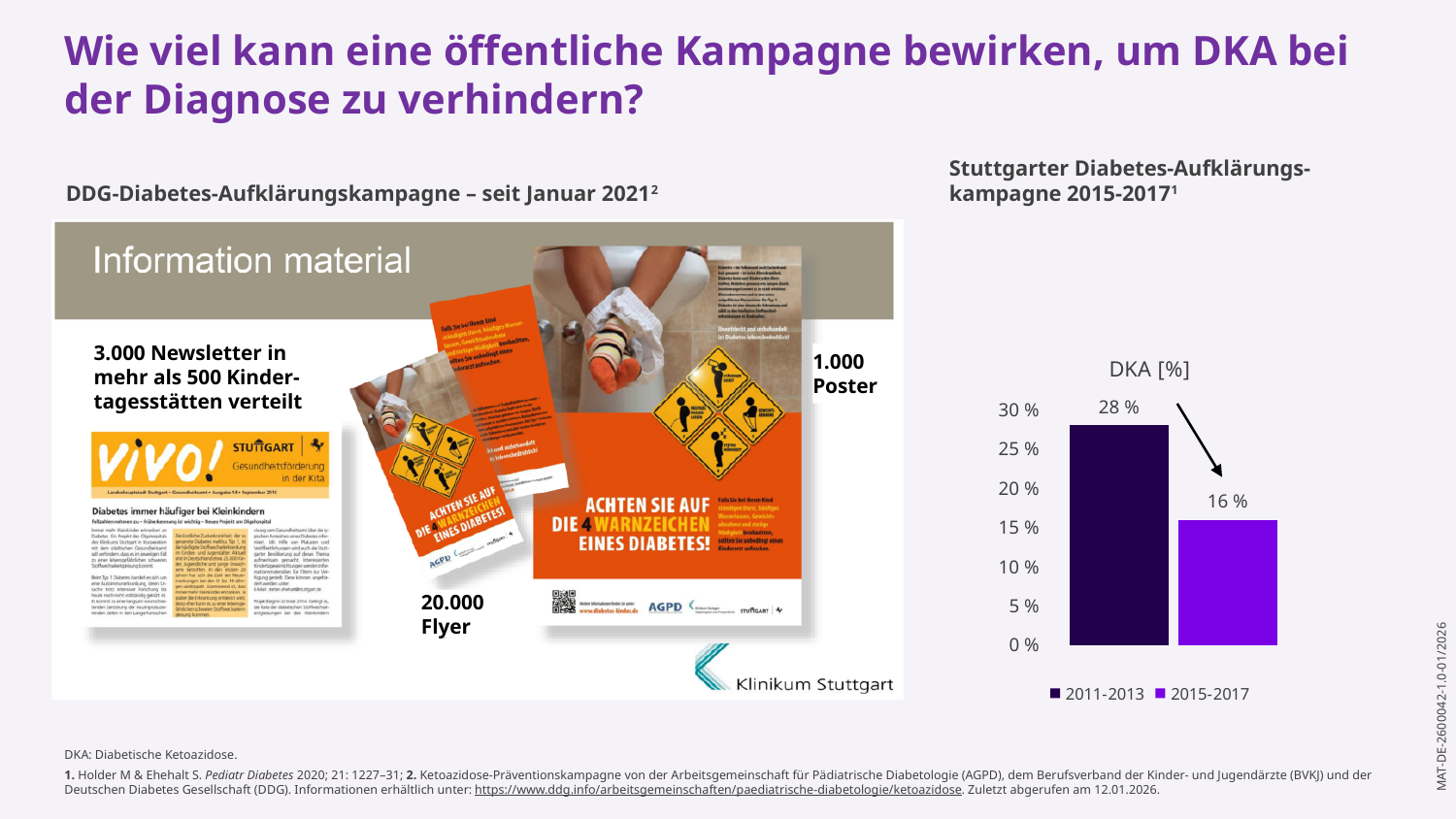
What is the title of the chart? DKA [%] Which period has the lower DKA value? 2015-2017 How many entries does the chart legend list? 2 Which period has the higher DKA value? 2011-2013 What is the DKA value for 2011-2013? 28 % Is the DKA value for 2015-2017 greater or less than 20 %? less Is the DKA value for 2011-2013 greater or less than 25 %? greater What is the difference between the DKA values for 2011-2013 and 2015-2017? 12 % What is the DKA value for 2015-2017? 16 % Is the DKA value for 2015-2017 larger or smaller than the value for 2011-2013? smaller What type of chart is shown on the slide? bar chart How many bars are shown in the chart? 2